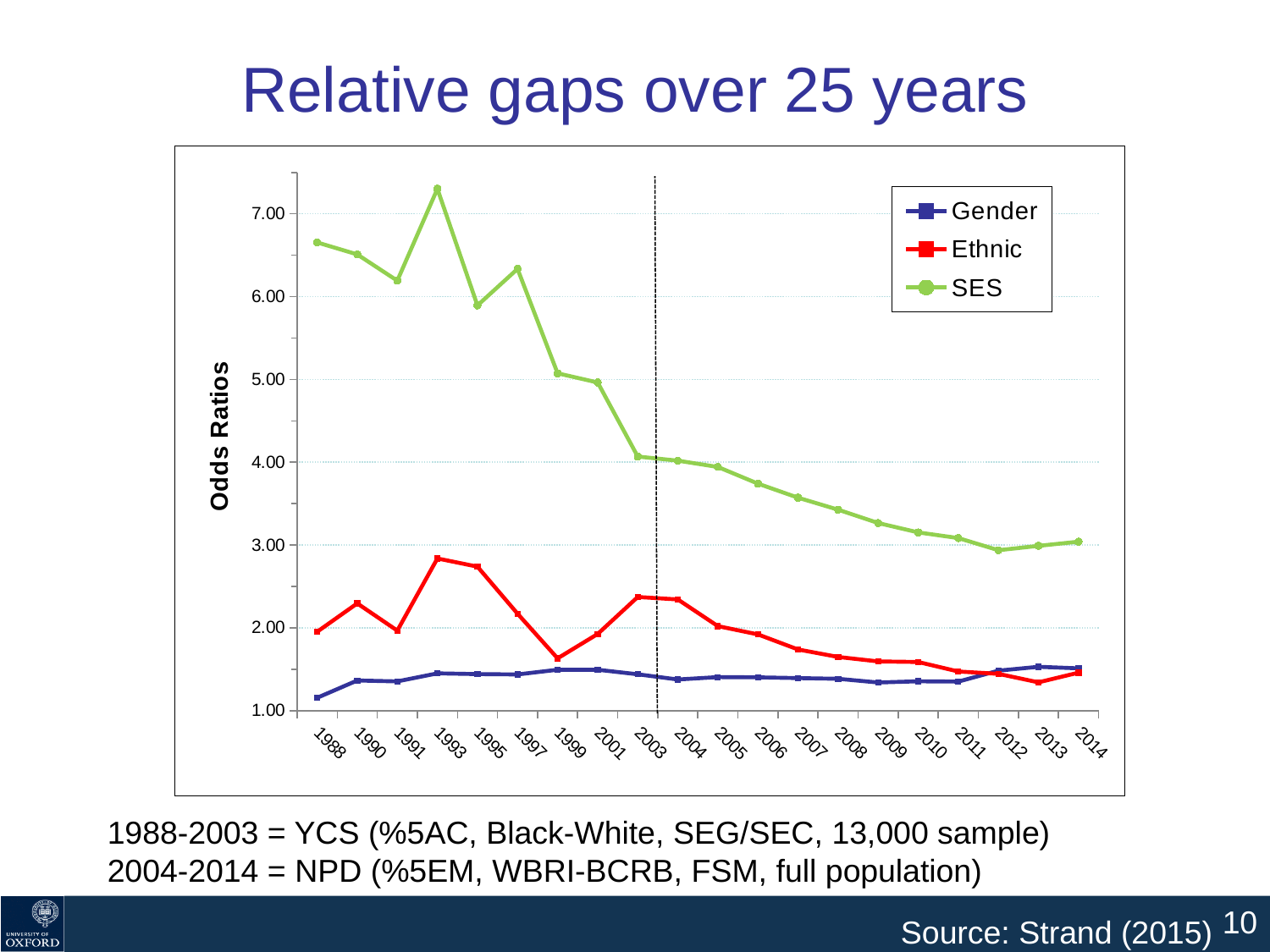
What kind of chart is shown on the slide? line chart Which series has the lowest odds ratio in 1988? Gender Is the Ethnic value for 2003 greater or less than 2.00? greater What is the label on the y axis? Odds Ratios How many series does the legend list? 3 Which series has the highest odds ratio in 1993? SES Does the SES series generally rise or fall from 1988 to 2014? fall Is the SES value for 1993 greater or less than 7.00? greater Which is larger in 2014, the SES value or the Ethnic value? SES How many years are shown on the x axis? 20 Is the Ethnic value for 1993 greater or less than 3.00? less